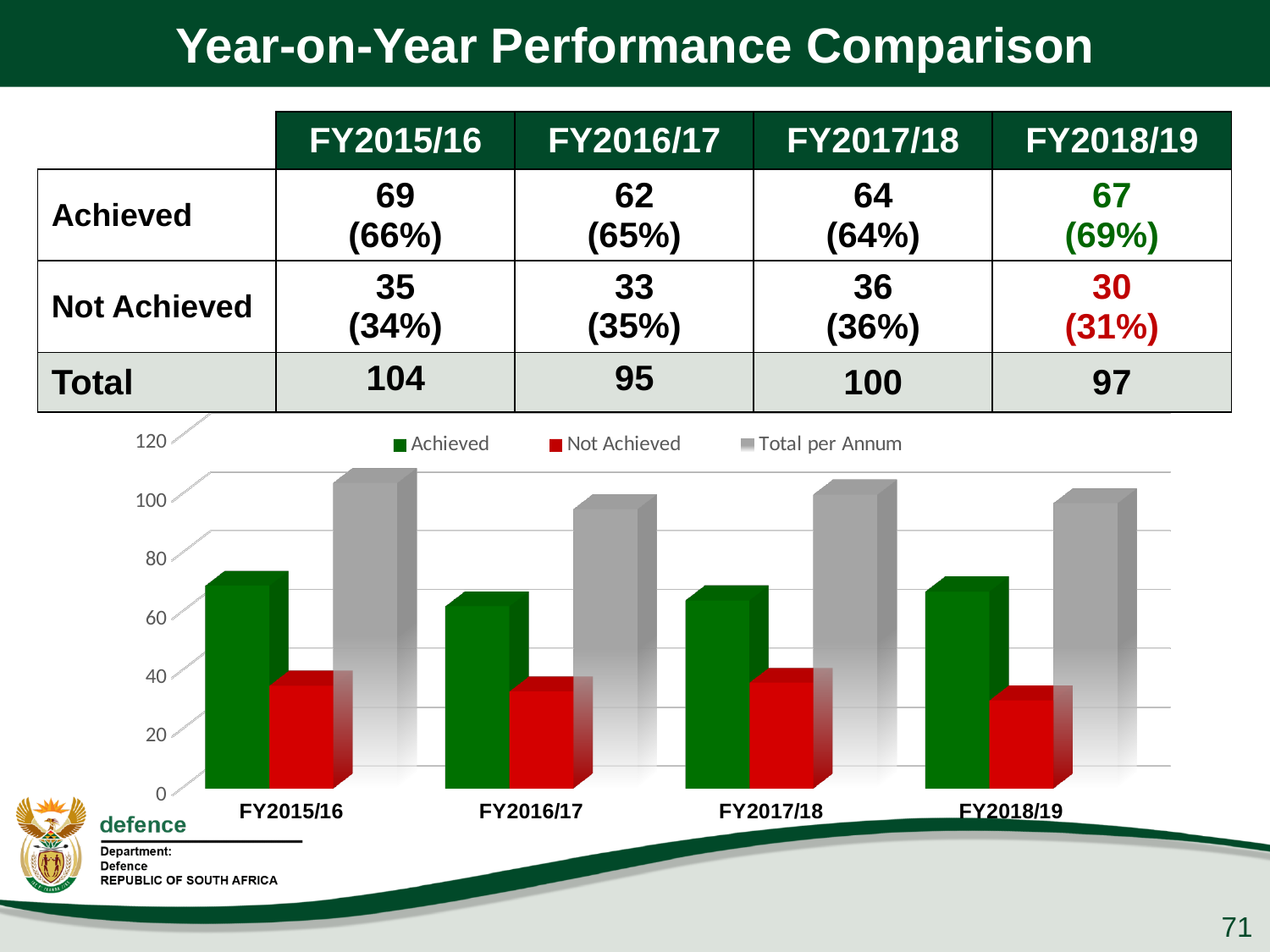
Is the Total per Annum value for FY2016/17 greater or less than 100? less What is the Total per Annum value for FY2015/16? 104 How many fiscal years are shown on the x axis of the chart? 4 How many series does the chart legend list? 3 Which fiscal year has the highest Achieved value? FY2015/16 What is the Not Achieved value for FY2016/17? 33 What kind of chart is shown on the slide? bar chart Which is larger, the Achieved value for FY2016/17 or the Achieved value for FY2018/19? FY2018/19 Which series in the chart legend is shown in red? Not Achieved What is the difference between the Achieved and Not Achieved values for FY2017/18? 28 What is the Achieved value for FY2018/19? 67 Which fiscal year has the lowest Not Achieved value? FY2018/19